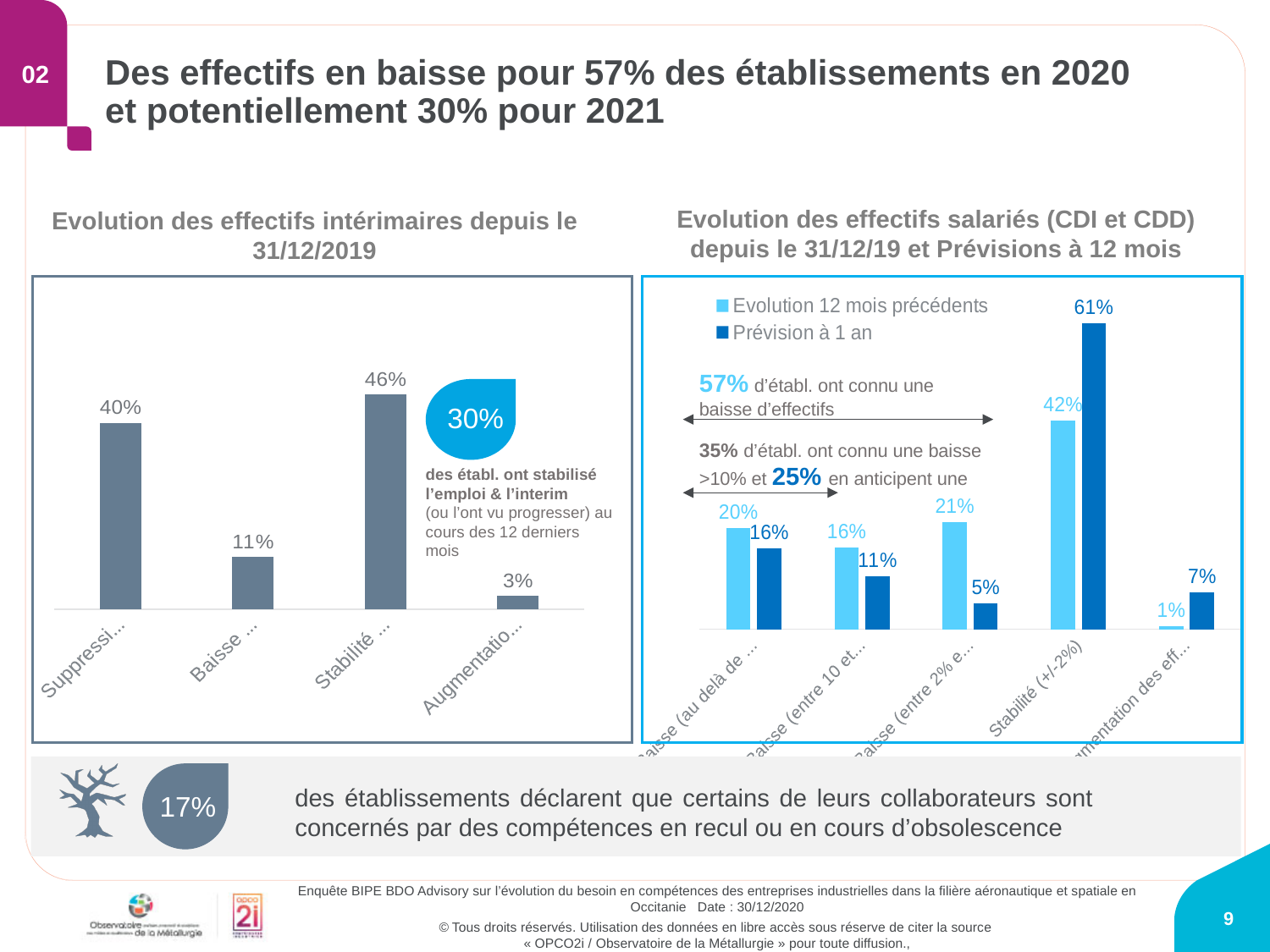
In the right chart 'Evolution des effectifs salariés (CDI et CDD)', what is the 'Prévision à 1 an' value for 'Stabilité (+/-2%)'? 61% In the left chart 'Evolution des effectifs intérimaires depuis le 31/12/2019', which category has the lowest value? Augmentation In the right chart 'Evolution des effectifs salariés (CDI et CDD)', which series is shown in dark blue? Prévision à 1 an What type of chart is the left chart 'Evolution des effectifs intérimaires depuis le 31/12/2019'? Bar chart How many categories are shown in the left chart 'Evolution des effectifs intérimaires depuis le 31/12/2019'? 4 In the left chart 'Evolution des effectifs intérimaires depuis le 31/12/2019', which category has the highest value? Stabilité How many series does the legend list in the right chart 'Evolution des effectifs salariés (CDI et CDD)'? 2 In the left chart 'Evolution des effectifs intérimaires depuis le 31/12/2019', what is the value for the 'Stabilité' category? 46% In the right chart 'Evolution des effectifs salariés (CDI et CDD)', what is the difference between the 'Prévision à 1 an' and 'Evolution 12 mois précédents' values for 'Stabilité (+/-2%)'? 19% In the right chart 'Evolution des effectifs salariés (CDI et CDD)', which is larger for the 'Augmentation des effectifs' category: 'Evolution 12 mois précédents' or 'Prévision à 1 an'? Prévision à 1 an In the left chart 'Evolution des effectifs intérimaires depuis le 31/12/2019', what is the difference between the 'Suppression' value and the 'Baisse' value? 29% In the right chart 'Evolution des effectifs salariés (CDI et CDD)', what is the 'Evolution 12 mois précédents' value for 'Stabilité (+/-2%)'? 42%